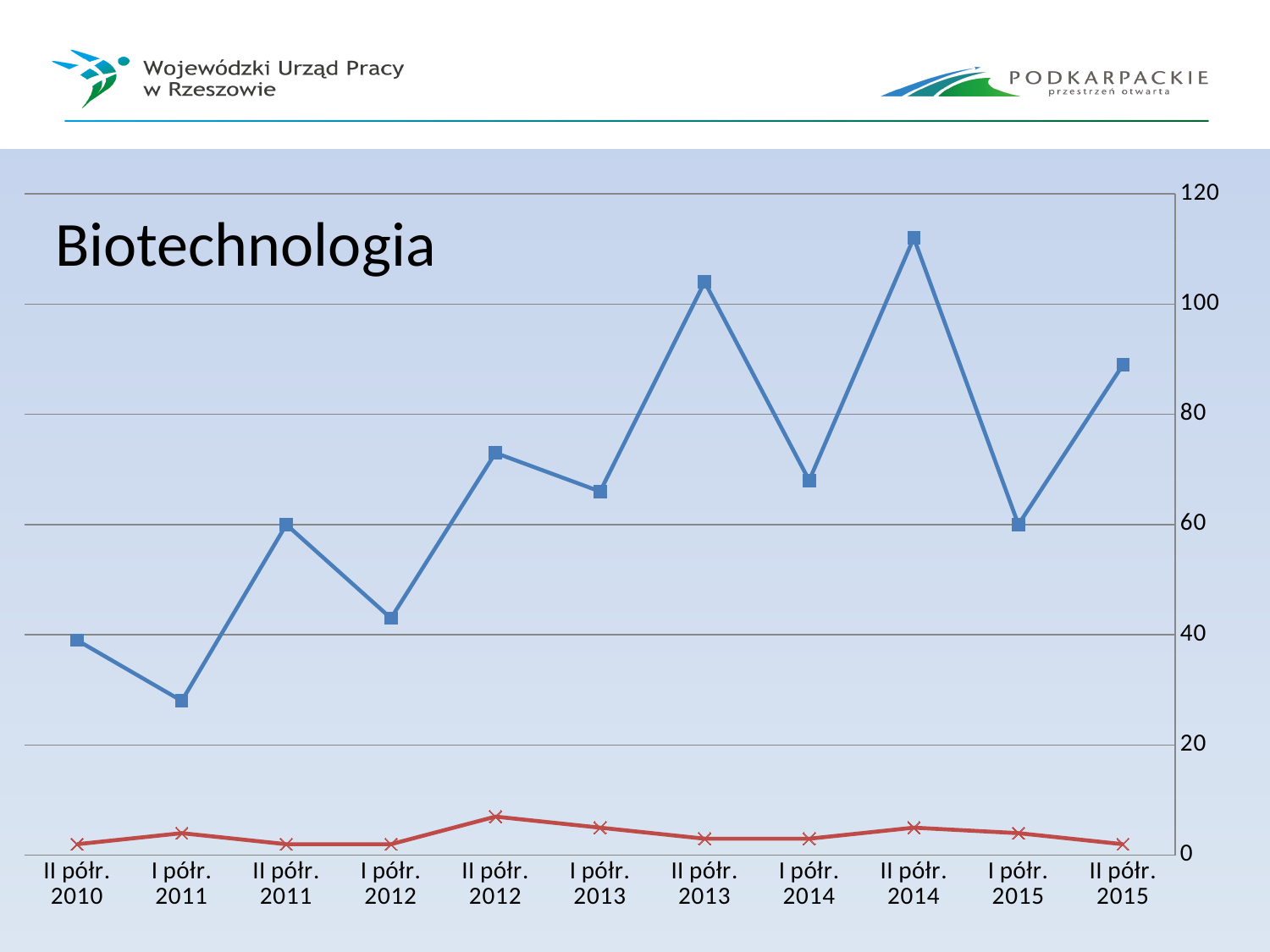
Is the value of the blue line for II półr. 2013 greater or less than 100? greater Does the blue line rise or fall from I półr. 2015 to II półr. 2015? rise What is the title of the chart? Biotechnologia In which period does the blue line reach its lowest value? I półr. 2011 Which is larger for the blue line: the value for II półr. 2013 or the value for I półr. 2014? II półr. 2013 Which line stays below 20 across all periods, the blue one or the red one? the red one Is the value of the blue line for I półr. 2011 greater or less than 40? less How many data series (lines) are plotted on the chart? 2 How many periods are shown along the x axis? 11 What kind of chart is shown on the slide? line chart Is the value of the blue line for II półr. 2015 greater or less than 80? greater In which period does the blue line reach its highest value? II półr. 2014